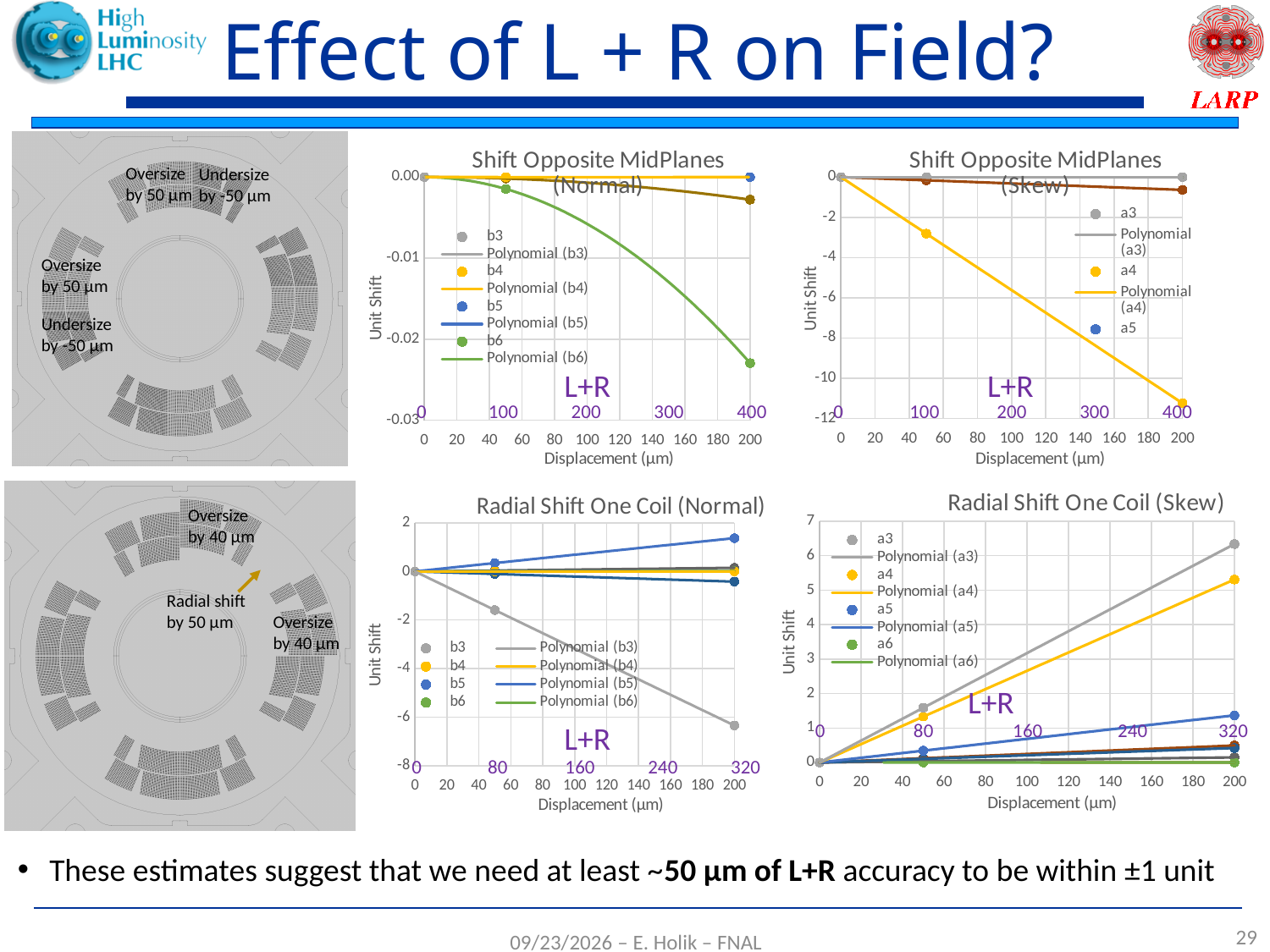
In "Shift Opposite MidPlanes (Normal)", is the b6 value at 200 µm displacement greater or less than -0.02? less In "Radial Shift One Coil (Skew)", is the a3 value at 200 µm displacement greater or less than 6? greater In "Radial Shift One Coil (Skew)", does the a3 series rise or fall as displacement increases? rise What kind of chart is "Shift Opposite MidPlanes (Normal)"? Scatter chart with polynomial trend lines What is the x-axis title of the "Radial Shift One Coil (Normal)" chart? Displacement (µm) How many entries does the legend of "Shift Opposite MidPlanes (Skew)" list? 5 In "Radial Shift One Coil (Skew)", which series is higher at 200 µm displacement, a3 or a4? a3 How many entries does the legend of "Radial Shift One Coil (Skew)" list? 8 What is the y-axis title of the "Shift Opposite MidPlanes (Normal)" chart? Unit Shift In "Shift Opposite MidPlanes (Skew)", is the a4 value at 200 µm displacement greater or less than -10? less In "Shift Opposite MidPlanes (Skew)", does the a4 series rise or fall as displacement increases? fall